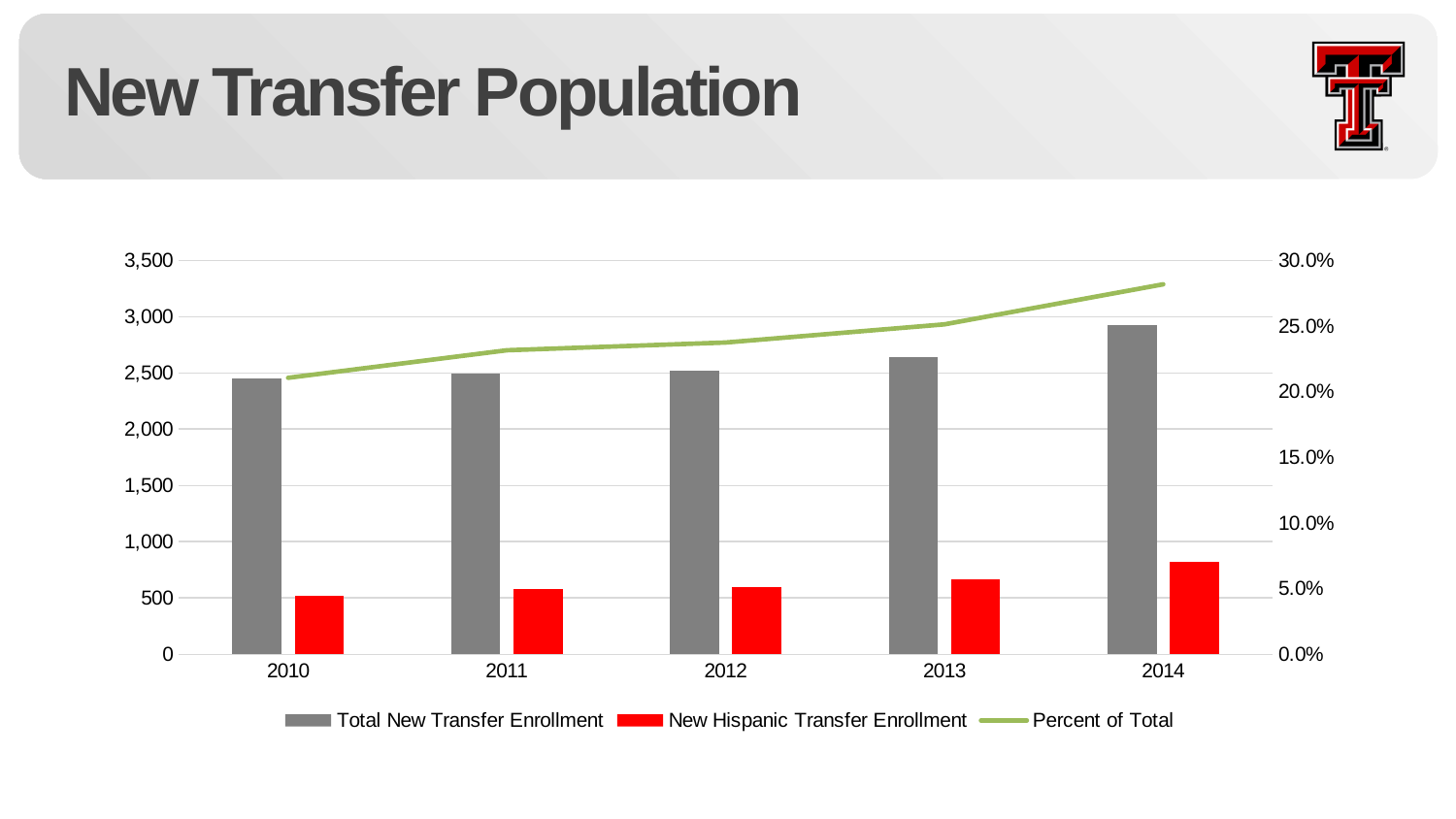
How many series does the legend list? 3 What colour are the New Hispanic Transfer Enrollment bars? Red Is the Percent of Total for 2014 greater or less than 25.0%? greater How many years are shown on the x axis? 5 Which is larger in 2013: Total New Transfer Enrollment or New Hispanic Transfer Enrollment? Total New Transfer Enrollment What is the title of the slide containing the chart? New Transfer Population Is the New Hispanic Transfer Enrollment for 2014 greater or less than 1,000? less Which year has the lowest New Hispanic Transfer Enrollment? 2010 Is the Total New Transfer Enrollment for 2014 greater or less than 2,500? greater Which year has the highest Total New Transfer Enrollment? 2014 Does the Percent of Total line rise or fall from 2010 to 2014? rise